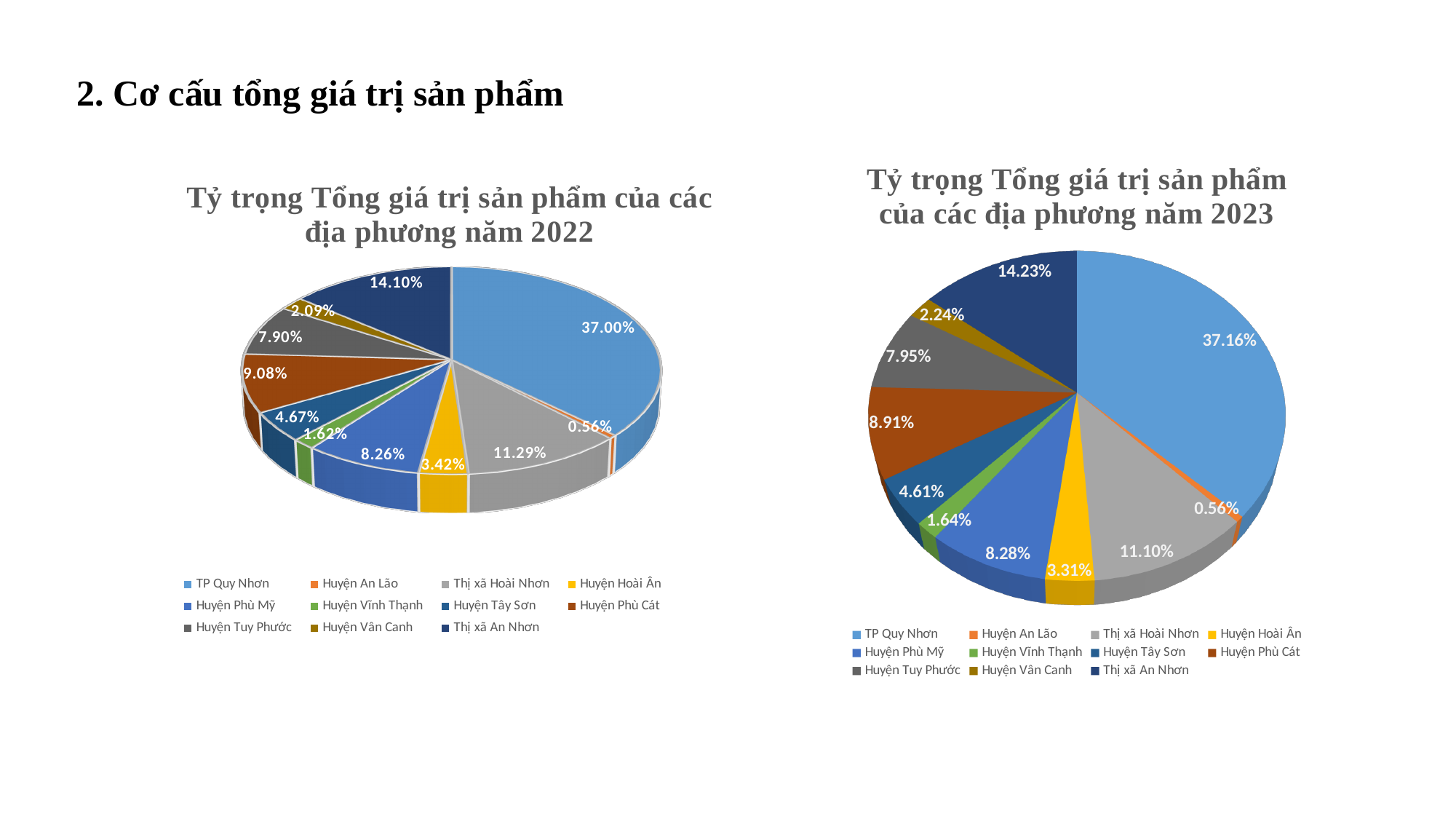
In the 2022 chart (left), which locality has the smallest share? Huyện An Lão What type of chart is the 2023 chart (right)? Pie chart In the 2023 chart (right), what share does Huyện Vân Canh have? 2.24% What is the title of the chart on the left? Tỷ trọng Tổng giá trị sản phẩm của các địa phương năm 2022 In the 2023 chart (right), which locality has the largest share? TP Quy Nhơn In the 2023 chart (right), what share does Huyện Hoài Ân have? 3.31% In the 2023 chart (right), what share does Thị xã An Nhơn have? 14.23% In the 2022 chart (left), what is the difference between the shares of Thị xã An Nhơn and Thị xã Hoài Nhơn? 2.81% In the 2022 chart (left), what share does TP Quy Nhơn have? 37.00% In the 2023 chart (right), which is larger: the share of Huyện Phù Cát or Huyện Phù Mỹ? Huyện Phù Cát How many localities are shown in the 2022 chart (left)? 11 In the 2022 chart (left), what share does Huyện Phù Cát have? 9.08%